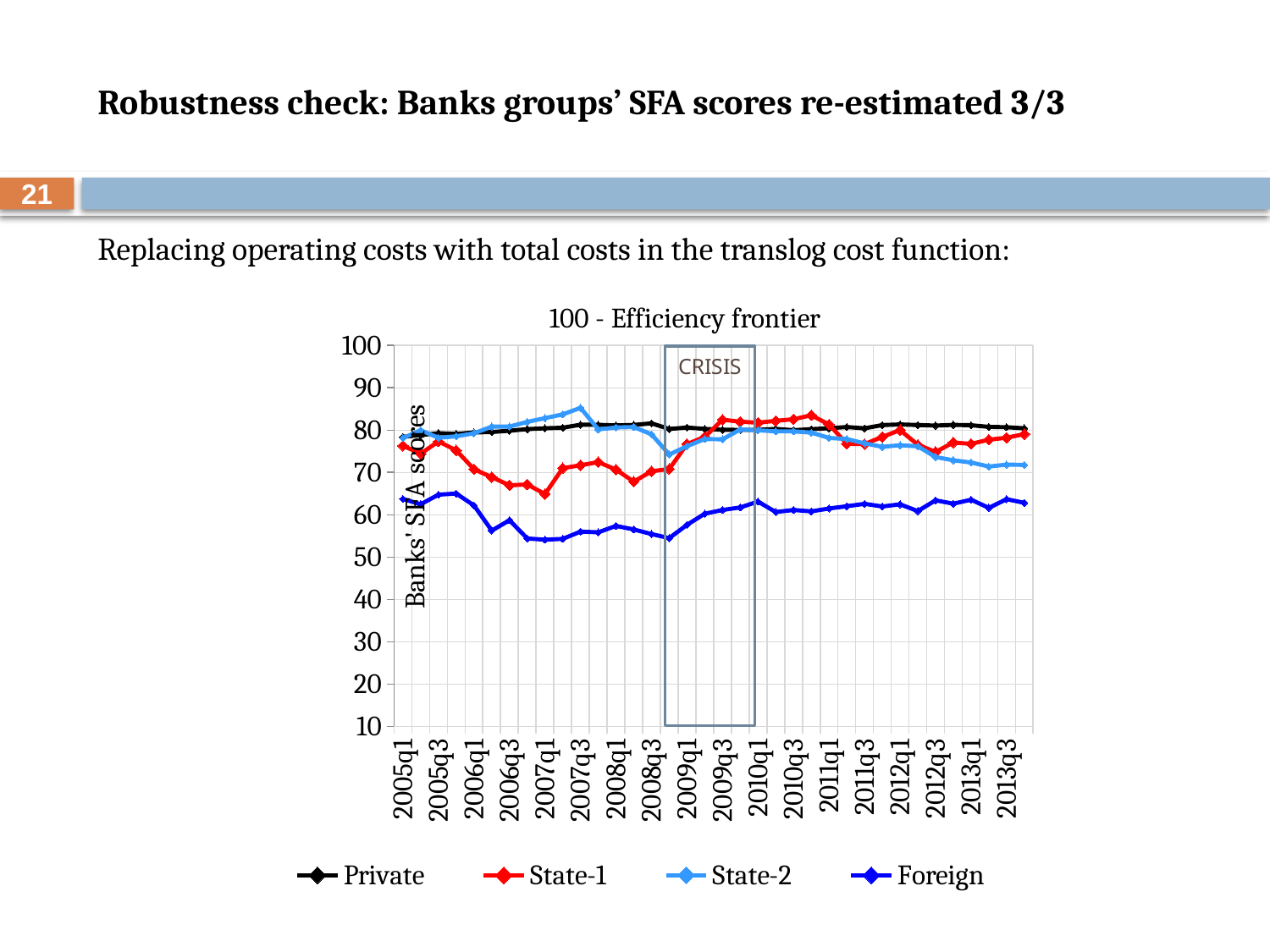
What label is written inside the boxed region on the chart? CRISIS Which series has the lowest value at 2005q1? Foreign Which is larger at 2007q1, the value for State-2 or the value for State-1? State-2 Which is larger at 2013q3, the value for Private or the value for Foreign? Private Is the value for State-2 at 2007q3 greater or less than 80? greater How many series does the legend list? 4 Does the Foreign series rise or fall from 2005q3 to 2007q1? fall What is the title of the chart? 100 - Efficiency frontier Is the value for State-1 at 2007q1 greater or less than 70? less What kind of chart is shown on the slide? line chart Is the value for Foreign at 2005q1 greater or less than 70? less